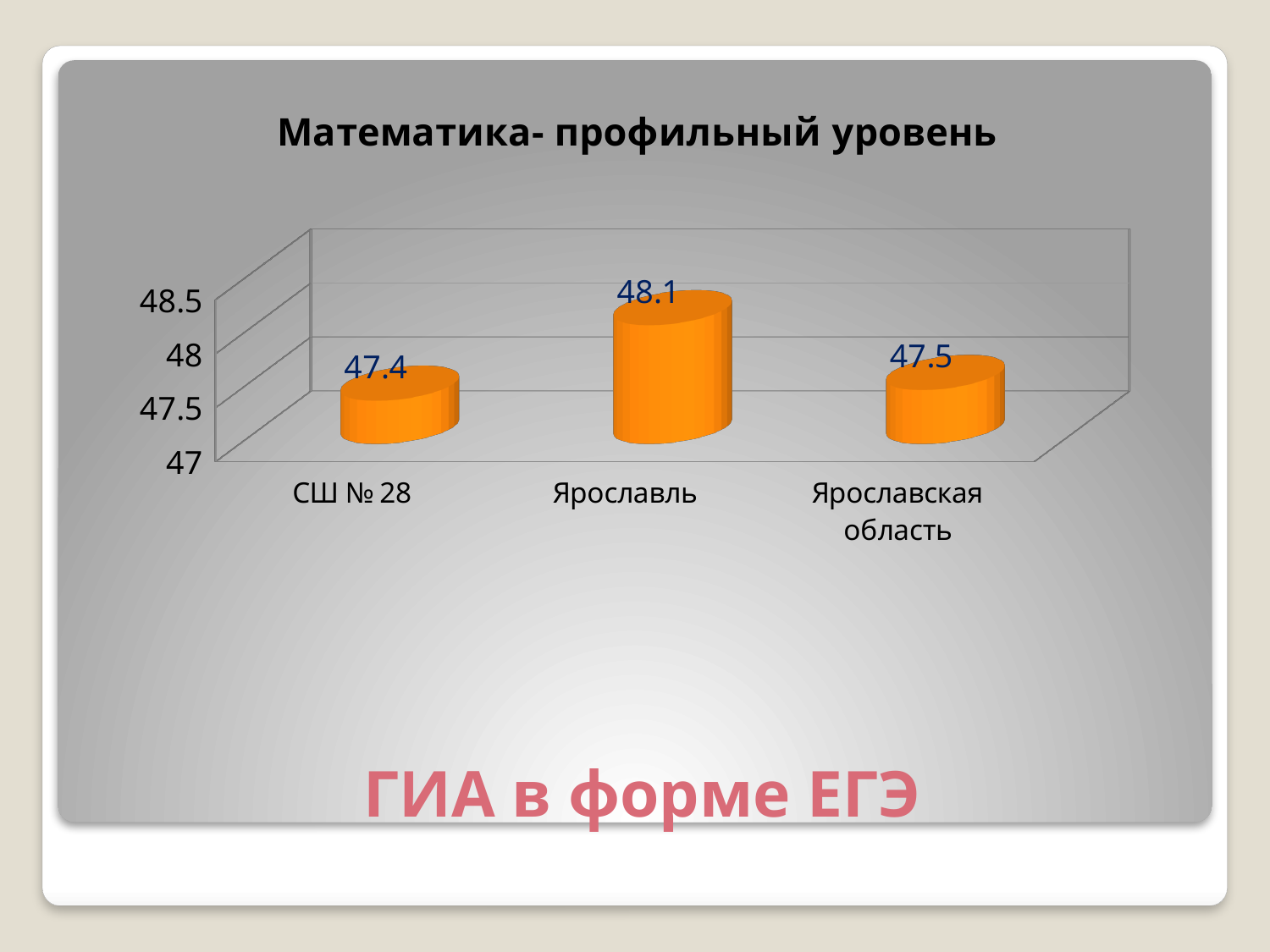
What is the difference between the values for Ярославль and СШ № 28? 0.7 Is the value for Ярославль greater or less than 48? greater What is the title of the chart? Математика- профильный уровень What is the difference between the values for Ярославская область and СШ № 28? 0.1 What is the value for СШ № 28? 47.4 Which is larger, the value for Ярославль or the value for Ярославская область? Ярославль How many categories are shown on the chart? 3 Which category has the lowest value? СШ № 28 Which category has the highest value? Ярославль What is the value for Ярославль? 48.1 What kind of chart is shown on the slide? bar chart What is the value for Ярославская область? 47.5